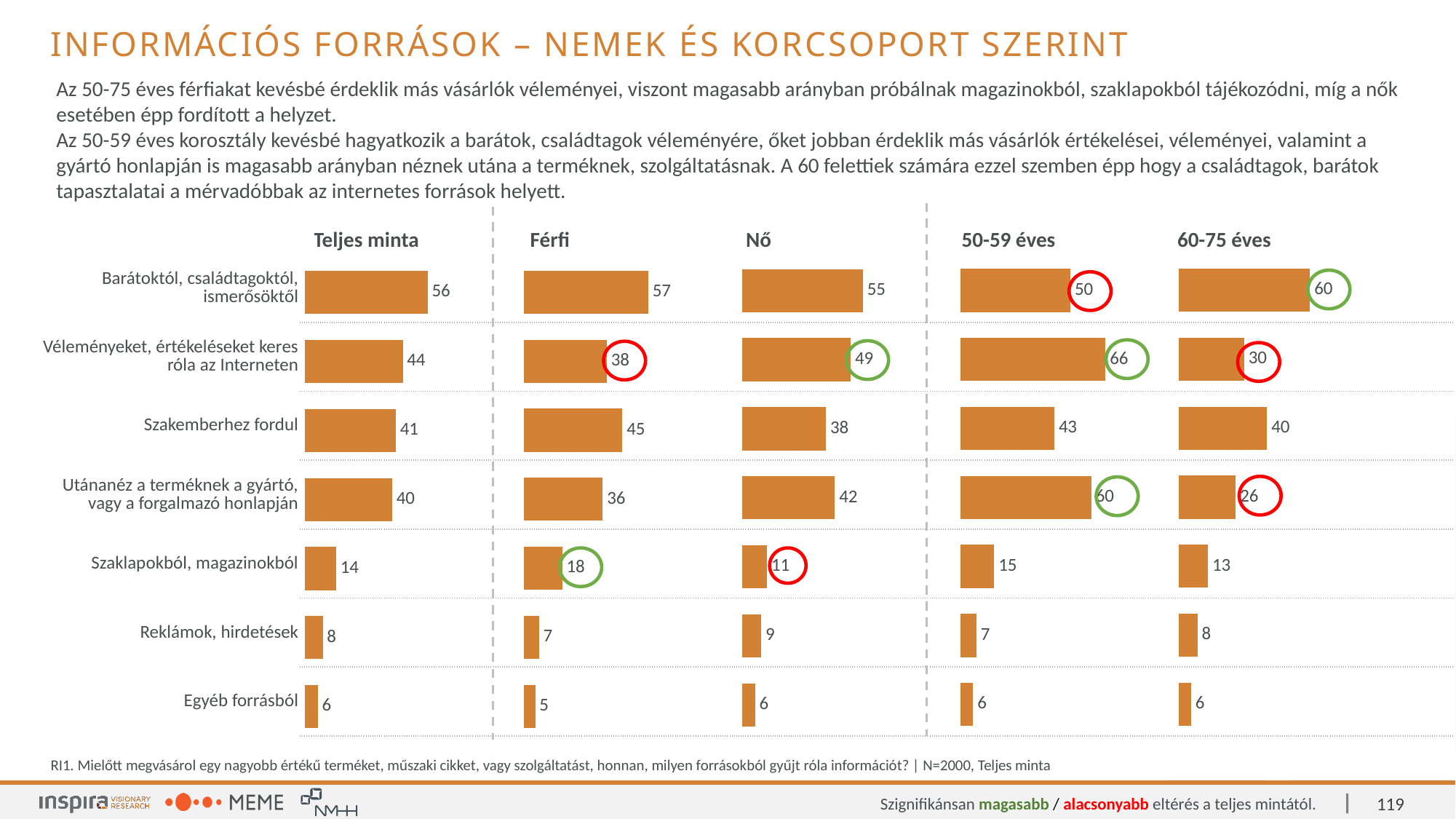
In the "60-75 éves" chart, which category has the lowest value? Egyéb forrásból How many separate bar charts are shown on the slide? 5 Which is larger: the value for "Utánanéz a terméknek a gyártó, vagy a forgalmazó honlapján" in the "50-59 éves" chart or in the "60-75 éves" chart? 50-59 éves In the "60-75 éves" chart, what is the difference between "Barátoktól, családtagoktól, ismerősöktől" and "Véleményeket, értékeléseket keres róla az Interneten"? 30 In the "Teljes minta" chart, what is the value for "Barátoktól, családtagoktól, ismerősöktől"? 56 In the "Nő" chart, what is the value for "Szaklapokból, magazinokból"? 11 In the "Férfi" chart, which category has the highest value? Barátoktól, családtagoktól, ismerősöktől In the "50-59 éves" chart, which category has the highest value? Véleményeket, értékeléseket keres róla az Interneten How many categories are shown in the "Teljes minta" chart? 7 In the "Nő" chart, what is the difference between "Szakemberhez fordul" and "Reklámok, hirdetések"? 29 In the "Férfi" chart, what is the value for "Véleményeket, értékeléseket keres róla az Interneten"? 38 What kind of chart is the "Férfi" chart? Bar chart